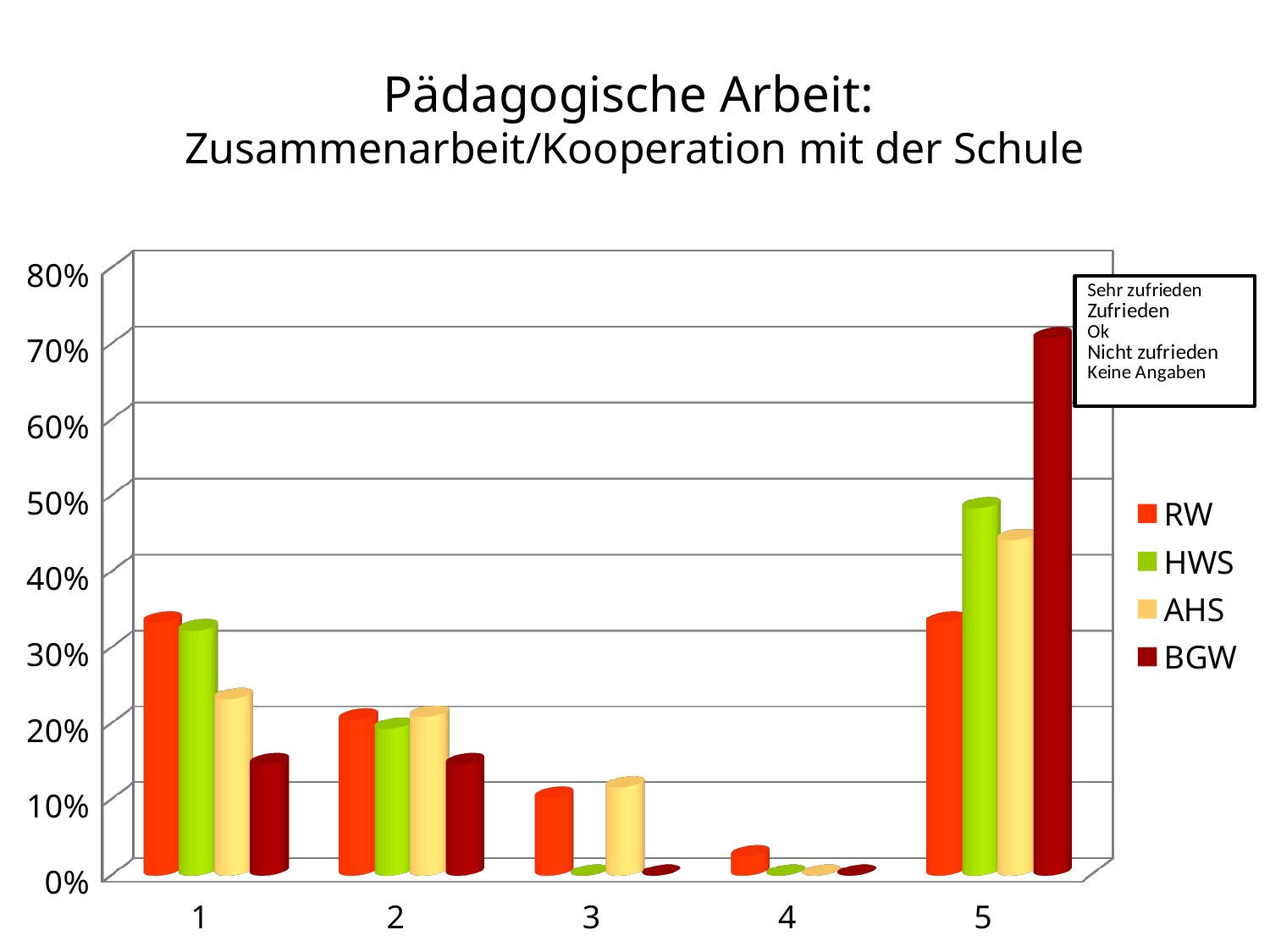
Which series has the lowest value in category 1? BGW What kind of chart is shown on the slide? bar chart Is the value for BGW in category 5 greater or less than 60%? greater How many categories are shown on the x axis? 5 Which series has the highest value in category 5? BGW Is the value for AHS in category 3 greater or less than 20%? less Is the value for RW in category 1 greater or less than 30%? greater What is the title of the chart? Pädagogische Arbeit: Zusammenarbeit/Kooperation mit der Schule How many series does the legend list? 4 In category 1, which is larger: the value for AHS or the value for BGW? AHS In category 5, which is larger: the value for HWS or the value for RW? HWS